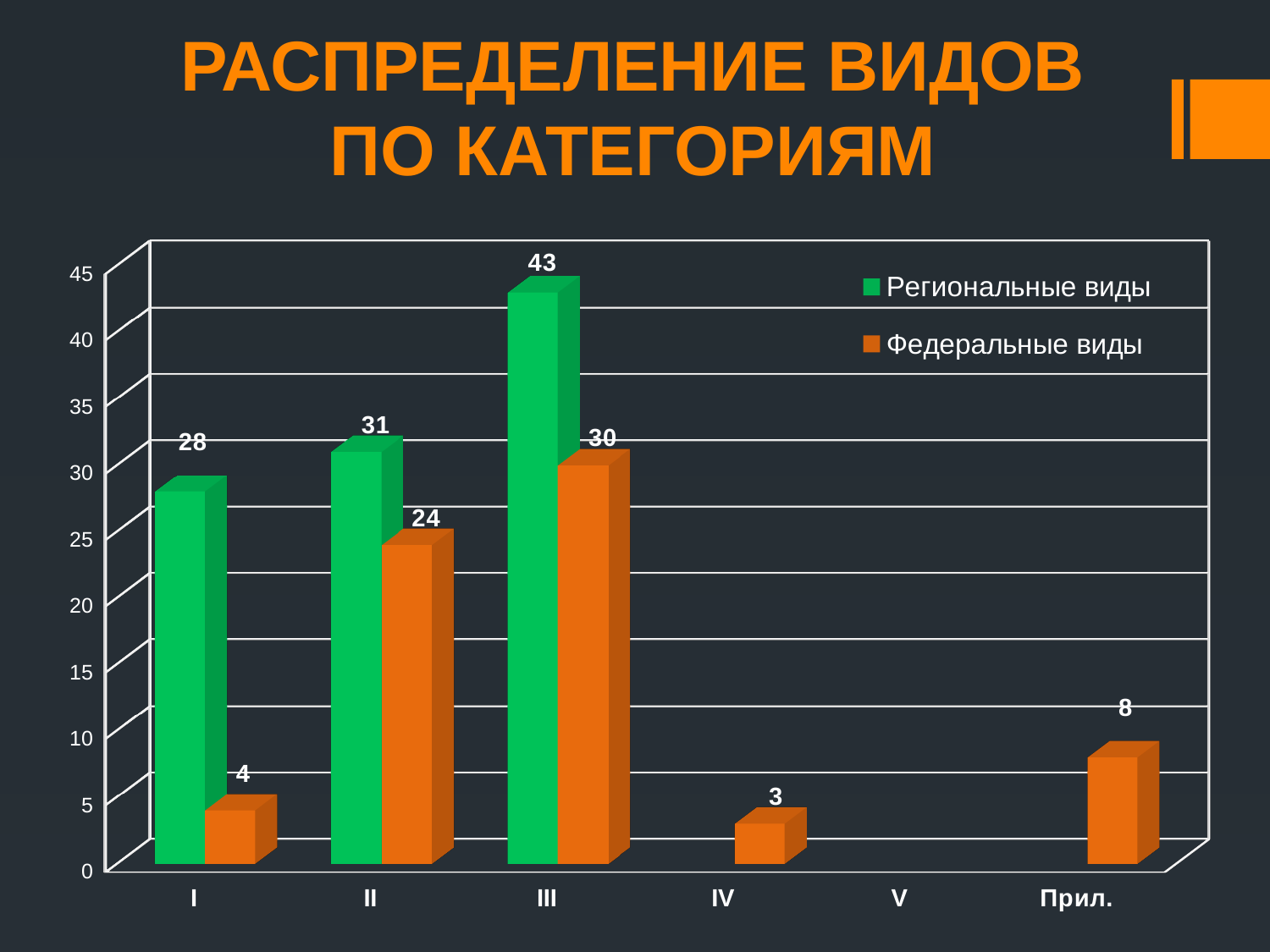
What colour are the bars for Федеральные виды? orange Which category has the highest value for Региональные виды? III What is the value for Федеральные виды in category Прил.? 8 What kind of chart is shown on the slide? bar chart What is the difference between Региональные виды and Федеральные виды in category I? 24 Which category has the lowest value for Федеральные виды among those with a labelled bar? IV What is the value for Федеральные виды in category I? 4 What is the difference between Региональные виды and Федеральные виды in category II? 7 What is the value for Региональные виды in category III? 43 Which is larger in category III: Региональные виды or Федеральные виды? Региональные виды How many series does the legend list? 2 How many categories are shown on the x axis? 6